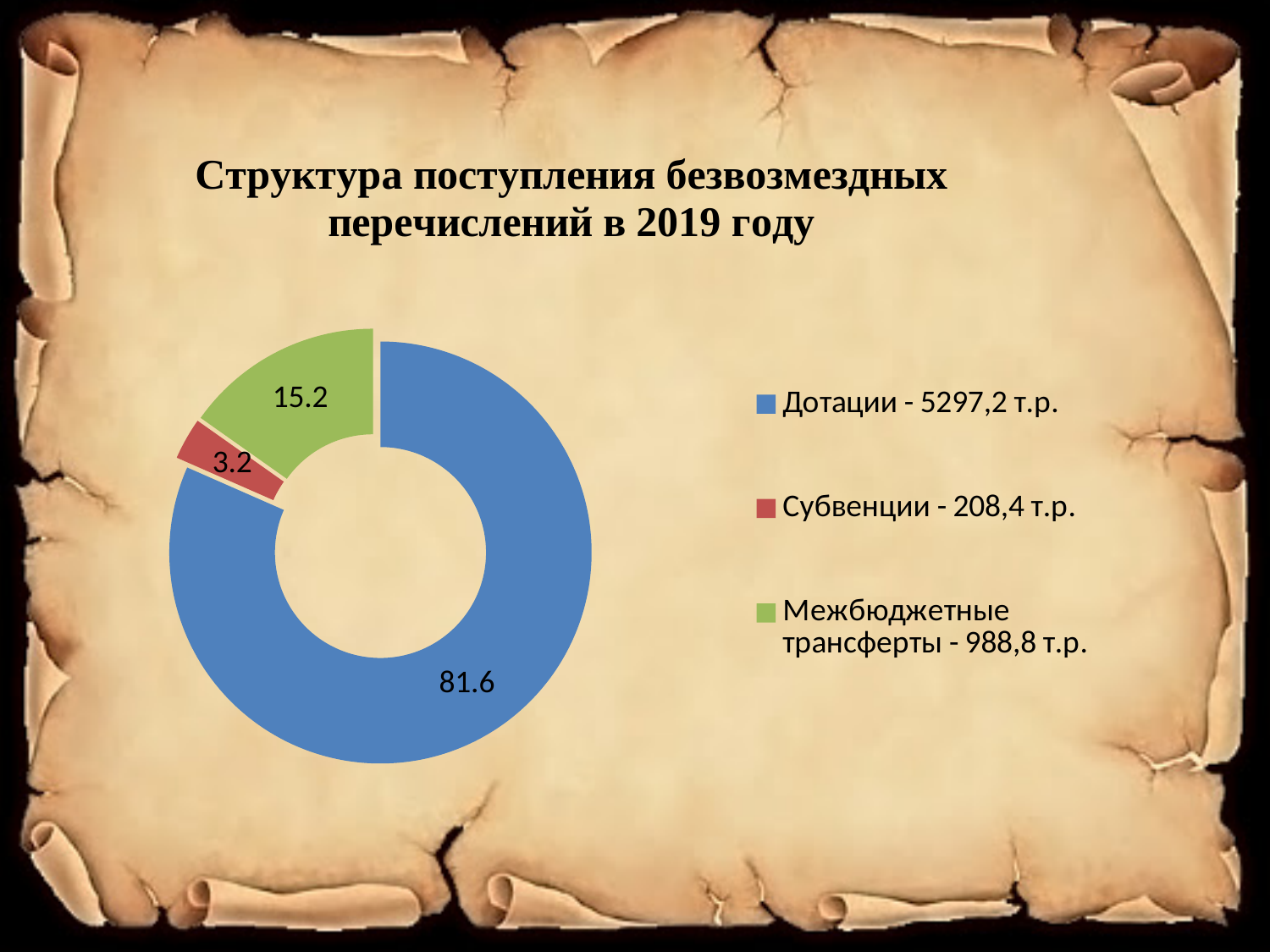
What is the data label shown on the Межбюджетные трансферты slice? 15.2 What is the data label shown on the Субвенции slice? 3.2 What is the difference between the data labels for Дотации and Межбюджетные трансферты? 66.4 What colour is the Дотации slice? Blue How many slices does the chart have? 3 Which category has the smallest slice in the chart? Субвенции What is the data label shown on the Дотации slice? 81.6 According to the legend, what amount is given for Субвенции? 208,4 т.р. What type of chart is shown on the slide? Doughnut (pie) chart Which slice is larger: Межбюджетные трансферты or Субвенции? Межбюджетные трансферты How many entries does the legend list? 3 Which category has the largest slice in the chart? Дотации